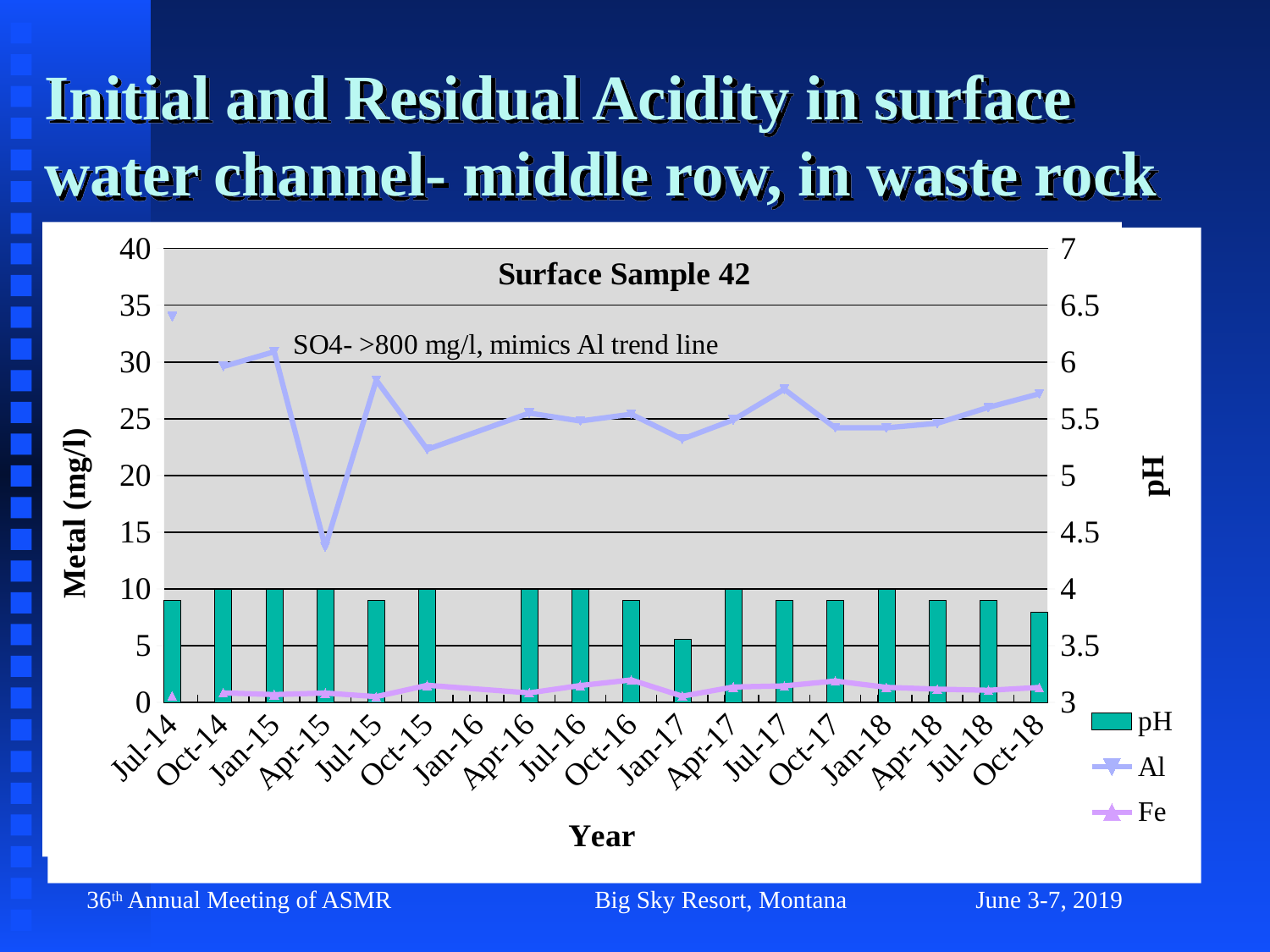
Which is larger, the Al value at Jan-15 or at Apr-15? Jan-15 At which date does the Al line reach its highest value? Jul-14 Is the Al value at Apr-15 greater or less than 20 mg/l? less At which date is the pH bar the shortest? Jan-17 How many series does the chart legend list? 3 What kind of chart is shown on the slide? Combination bar and line chart At which date does the Al line reach its lowest value? Apr-15 Does the Al line rise or fall between Apr-15 and Jul-15? rise Is the Al value at Jul-14 greater or less than 30 mg/l? greater What is the title of the chart on the slide? Surface Sample 42 Is the Al value at Jul-17 greater or less than 25 mg/l? greater How many dates are labelled along the x axis of the chart? 18